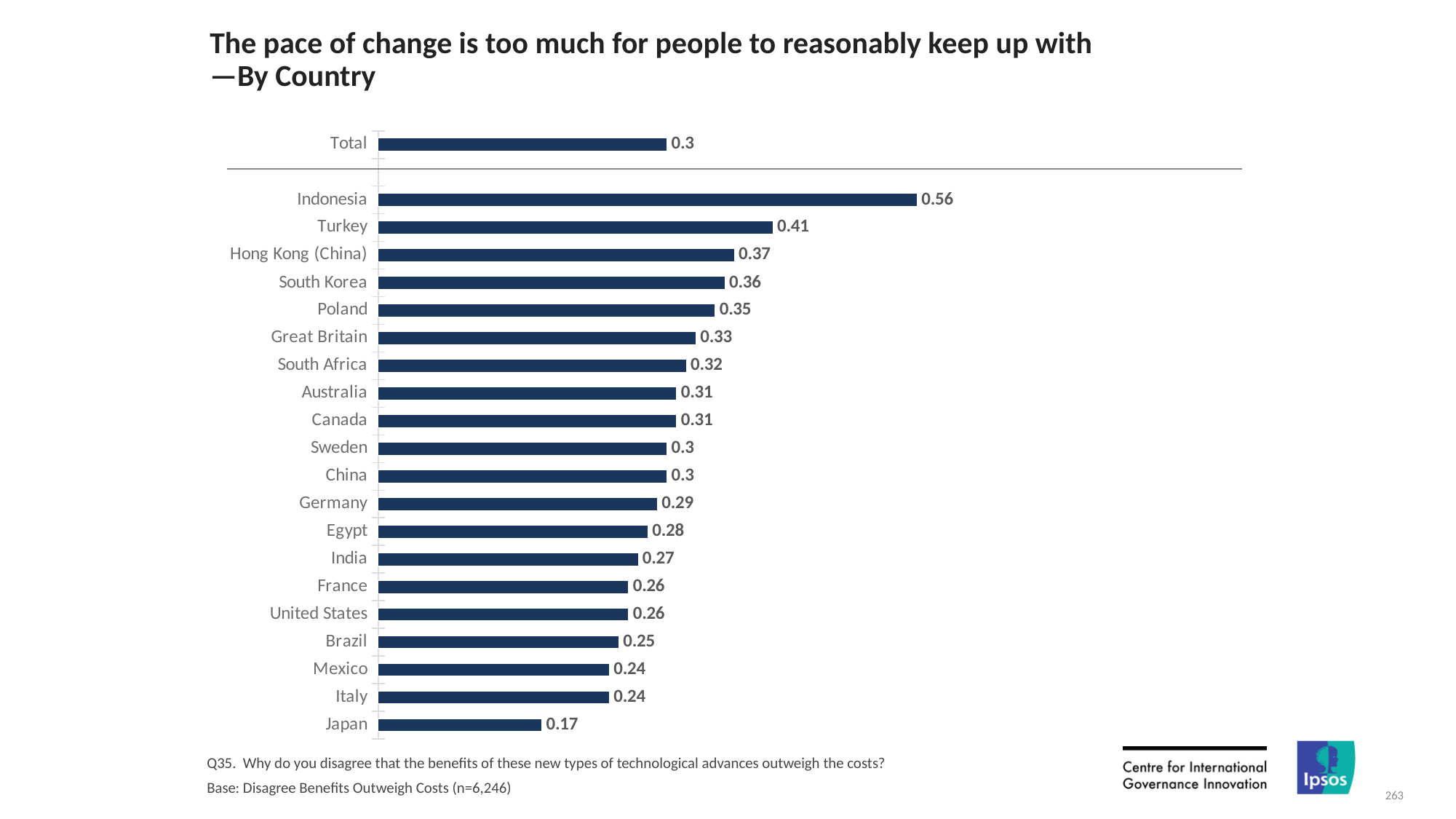
What type of chart is shown on the slide? Bar chart What is the title of the chart? The pace of change is too much for people to reasonably keep up with—By Country Which country has the lowest value? Japan What is the difference between the values for Poland and Japan? 0.18 What is the value for Japan? 0.17 What is the value for Indonesia? 0.56 Which has a larger value, South Korea or Germany? South Korea What is the value for the Total bar? 0.3 How many countries are shown in the chart, excluding the Total bar? 20 What is the difference between the values for Indonesia and Turkey? 0.15 Which country has the highest value? Indonesia What is the value for Hong Kong (China)? 0.37